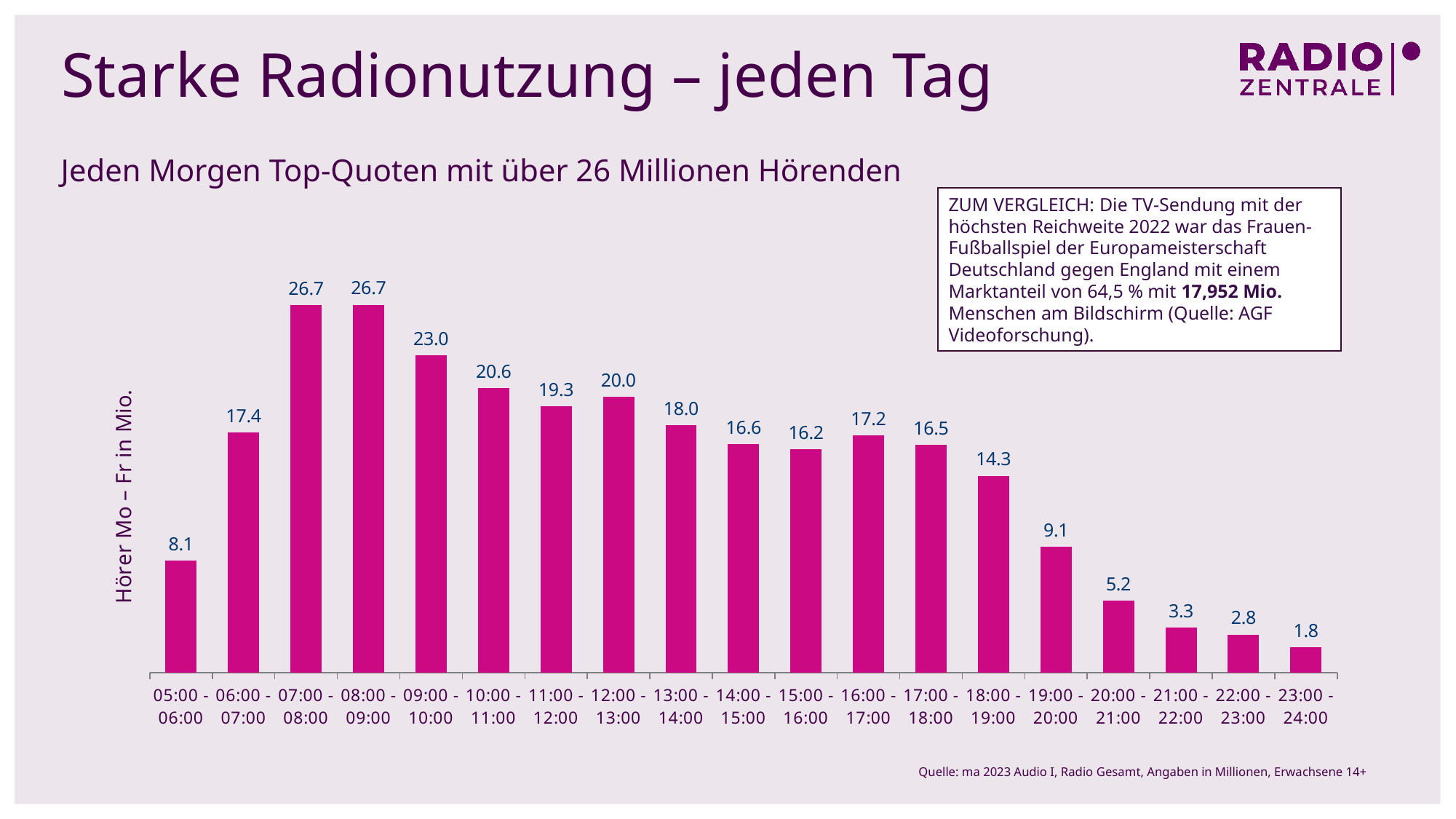
How many time slots are shown on the x axis? 19 Which time slot has the lowest value? 23:00 - 24:00 What is the highest value shown in the chart? 26.7 What kind of chart is shown on the slide? Bar chart What is the value for the 05:00 - 06:00 time slot? 8.1 What is the label of the y axis? Hörer Mo – Fr in Mio. What is the difference between the values for 09:00 - 10:00 and 10:00 - 11:00? 2.4 What is the value for the 18:00 - 19:00 time slot? 14.3 What is the value for the 12:00 - 13:00 time slot? 20.0 Do the values rise or fall from the 13:00 - 14:00 slot to the 23:00 - 24:00 slot? Fall What is the difference between the values for 19:00 - 20:00 and 20:00 - 21:00? 3.9 Which is larger, the value for 16:00 - 17:00 or the value for 17:00 - 18:00? 16:00 - 17:00